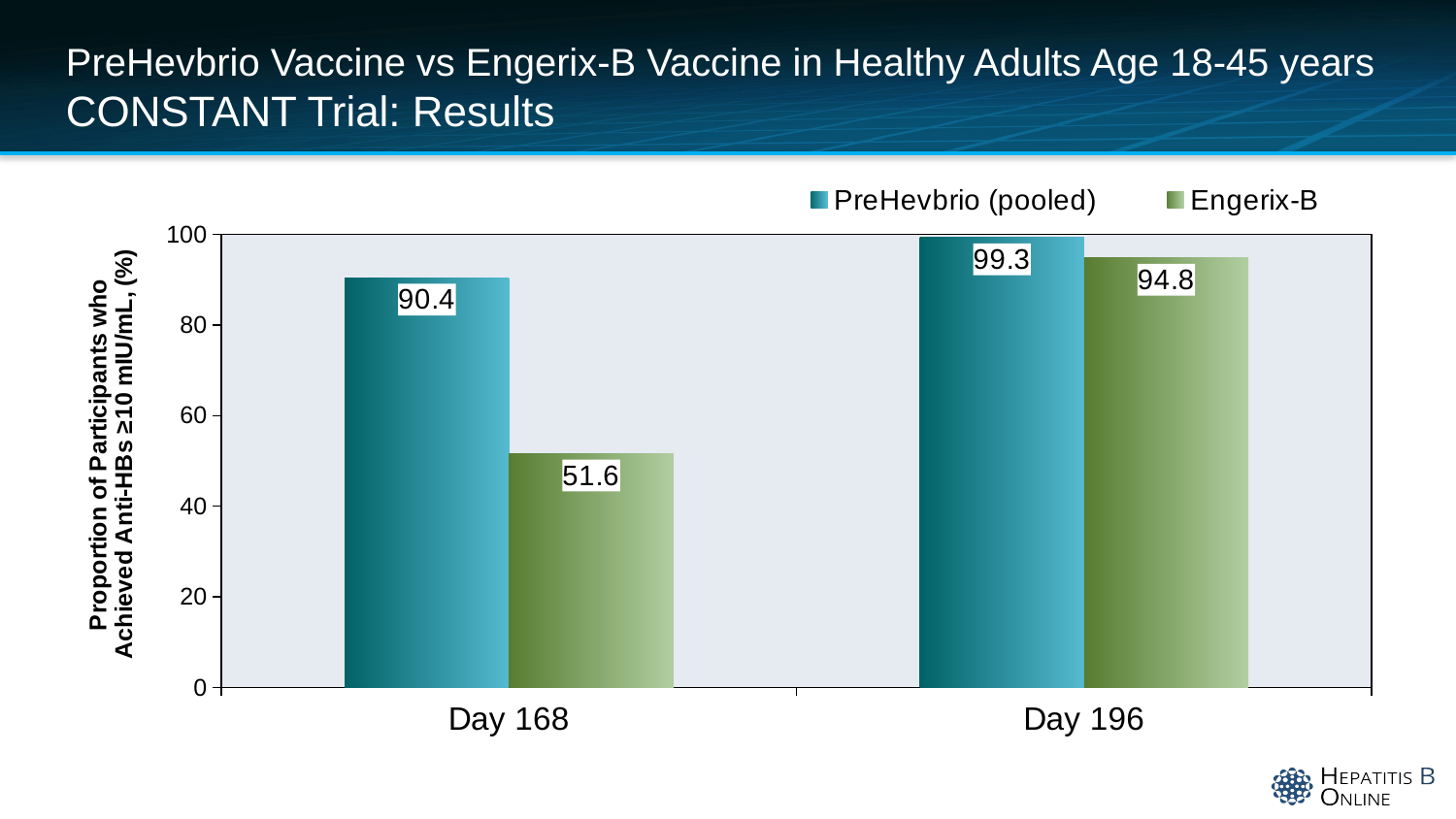
Which is larger at Day 196, PreHevbrio (pooled) or Engerix-B? PreHevbrio (pooled) What is the value for Engerix-B at Day 196? 94.8 How many series does the legend list? 2 Which bar has the lowest value on the chart? Engerix-B at Day 168 Which bar has the highest value on the chart? PreHevbrio (pooled) at Day 196 What kind of chart is shown on the slide? Bar chart Does the Engerix-B value rise or fall from Day 168 to Day 196? Rise What is the value for PreHevbrio (pooled) at Day 196? 99.3 What is the value for PreHevbrio (pooled) at Day 168? 90.4 What is the difference between the PreHevbrio (pooled) and Engerix-B values at Day 168? 38.8 What is the difference between the PreHevbrio (pooled) and Engerix-B values at Day 196? 4.5 What is the value for Engerix-B at Day 168? 51.6